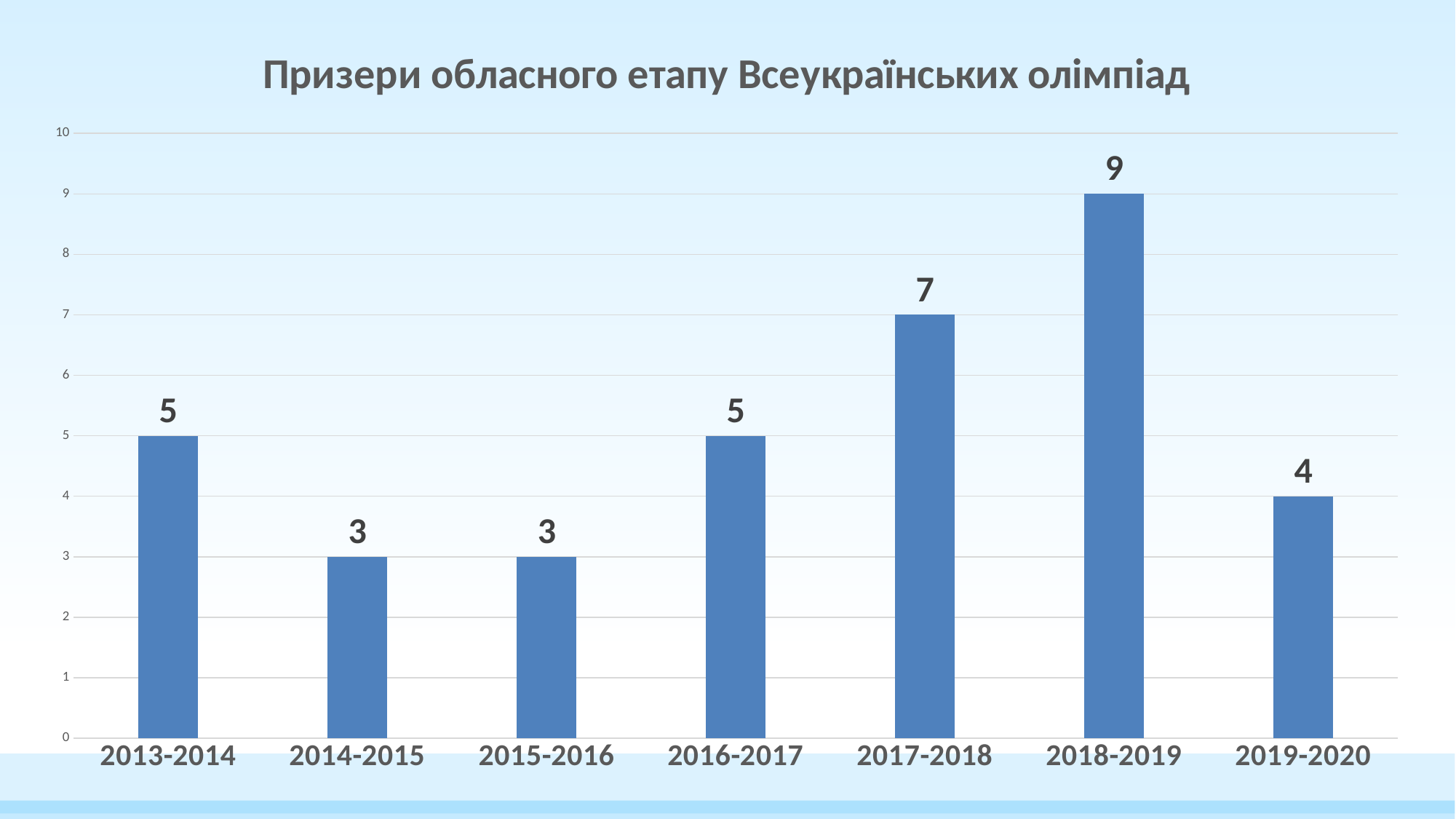
Which is larger, the value for 2017-2018 or the value for 2019-2020? 2017-2018 What is the value for 2019-2020? 4 Do the values rise or fall from 2015-2016 to 2018-2019? rise What kind of chart is this? bar chart Which year has the highest value? 2018-2019 How many years are shown on the x axis? 7 What is the value for 2014-2015? 3 What is the title of the chart? Призери обласного етапу Всеукраїнських олімпіад What is the value for 2018-2019? 9 What is the difference between the values for 2018-2019 and 2017-2018? 2 What is the difference between the values for 2013-2014 and 2014-2015? 2 Is the value for 2018-2019 greater or less than 8? greater